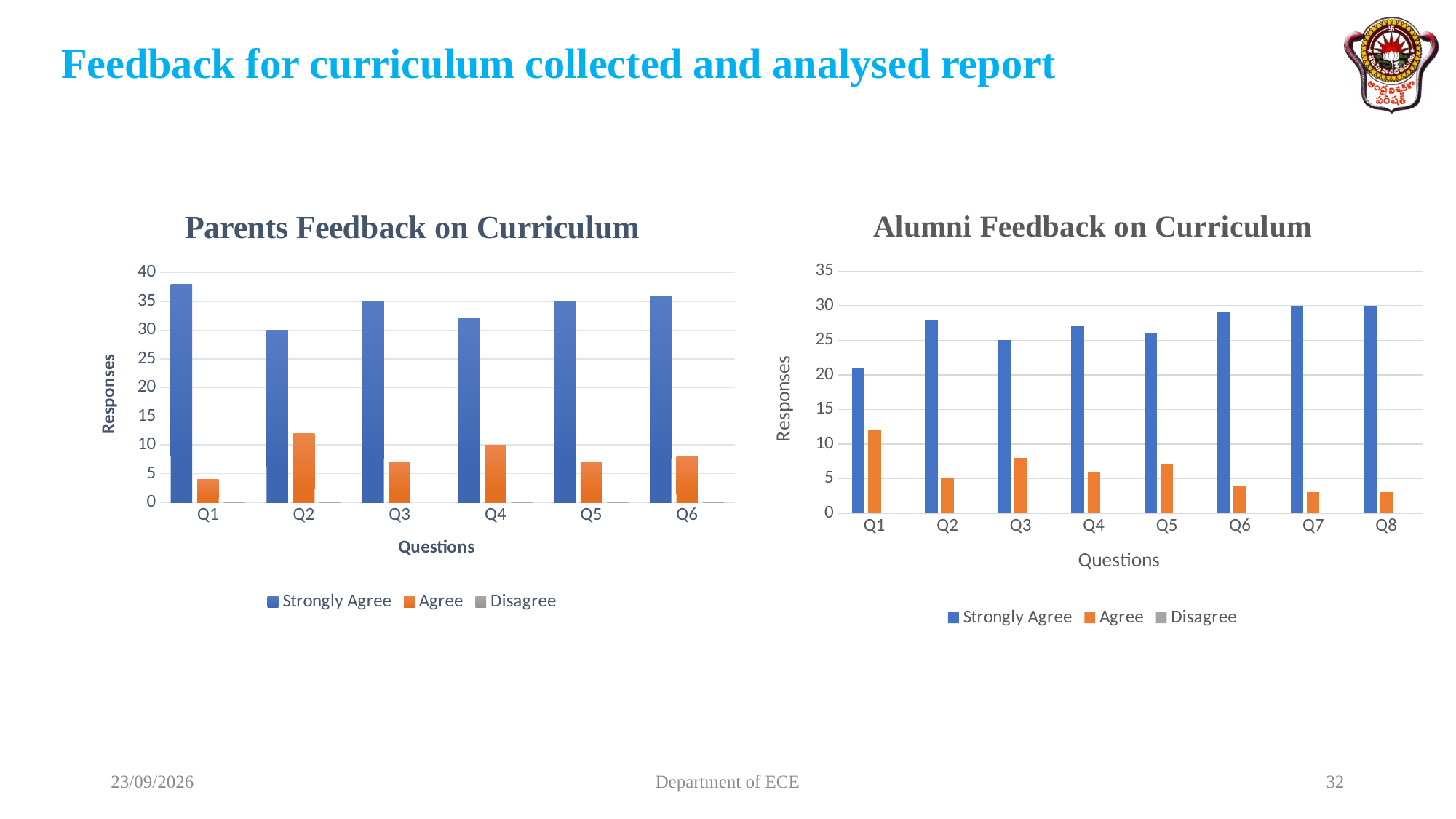
In the Alumni Feedback on Curriculum chart, what is the Agree value for Q2? 5 In the Alumni Feedback on Curriculum chart, which question has the lowest Strongly Agree value? Q1 How many questions are shown on the x axis of the Alumni Feedback on Curriculum chart? 8 In the Alumni Feedback on Curriculum chart, what is the Strongly Agree value for Q3? 25 In the Parents Feedback on Curriculum chart, which question has the highest Agree value? Q2 In the Parents Feedback on Curriculum chart, what is the Agree value for Q4? 10 In the Alumni Feedback on Curriculum chart, which question has the highest Agree value? Q1 How many series does the legend of the Parents Feedback on Curriculum chart list? 3 In the Alumni Feedback on Curriculum chart, is the Strongly Agree value for Q1 greater or less than 25? less In the Parents Feedback on Curriculum chart, which is larger, the Strongly Agree value for Q1 or for Q2? Q1 In the Parents Feedback on Curriculum chart, is the Strongly Agree value for Q1 greater or less than 35? greater In the Parents Feedback on Curriculum chart, what is the Strongly Agree value for Q2? 30